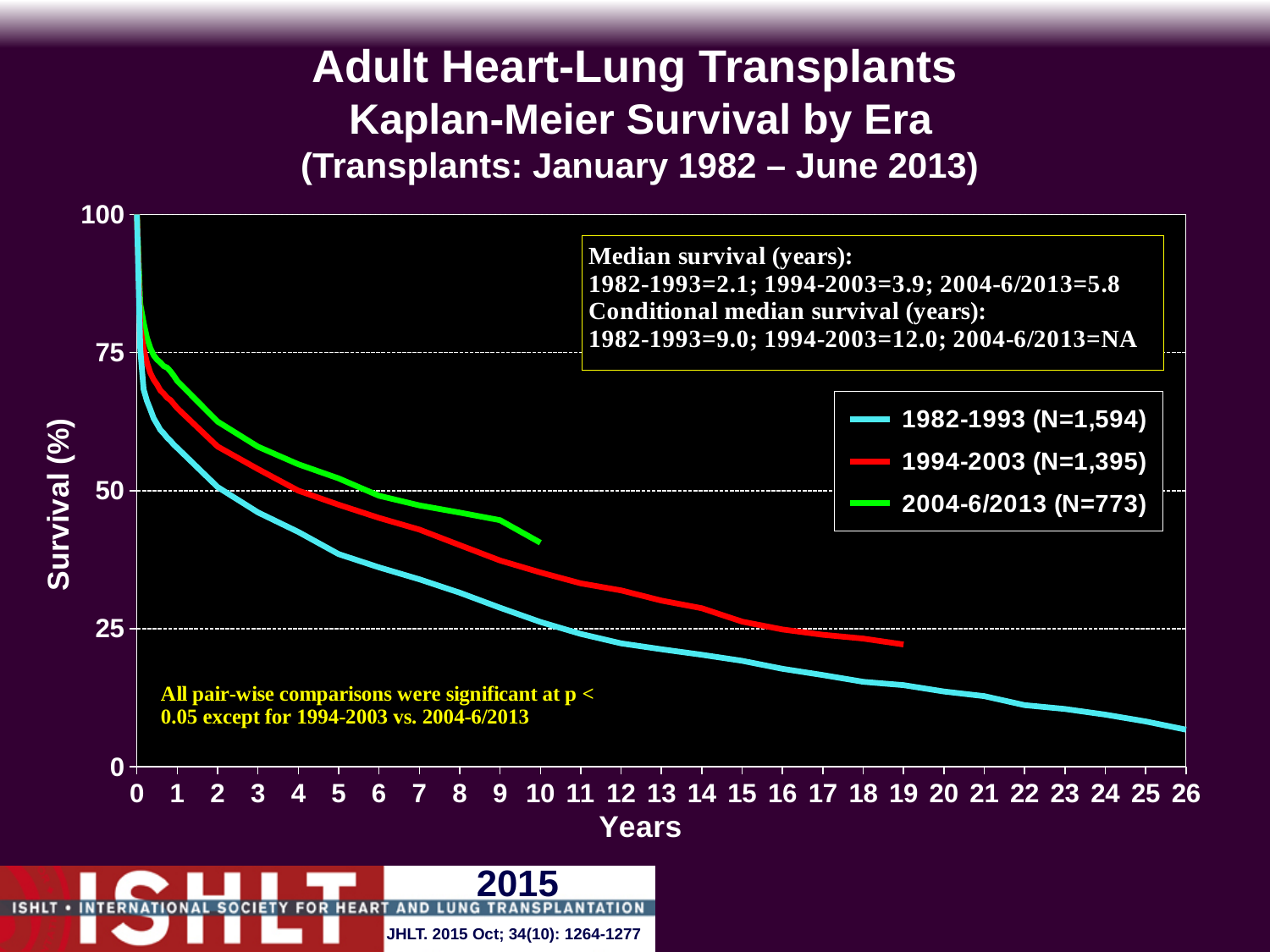
Is the survival for the 2004-6/2013 era at 2 years greater or less than 50? greater What kind of chart is shown on the slide? Line chart What is the difference in median survival (years) between the 2004-6/2013 era and the 1982-1993 era? 3.7 Which era's curve extends the furthest along the Years axis? 1982-1993 What is the N for the 1994-2003 era shown in the legend? 1,395 Do the survival curves rise or fall as years increase? Fall What is the median survival in years for the 1982-1993 era? 2.1 How many series does the legend list? 3 Is the survival for the 1982-1993 era at 5 years greater or less than 50? less Which era has the highest median survival? 2004-6/2013 What is the conditional median survival in years for the 1994-2003 era? 12.0 At 10 years, which era has higher survival: 1982-1993 or 2004-6/2013? 2004-6/2013